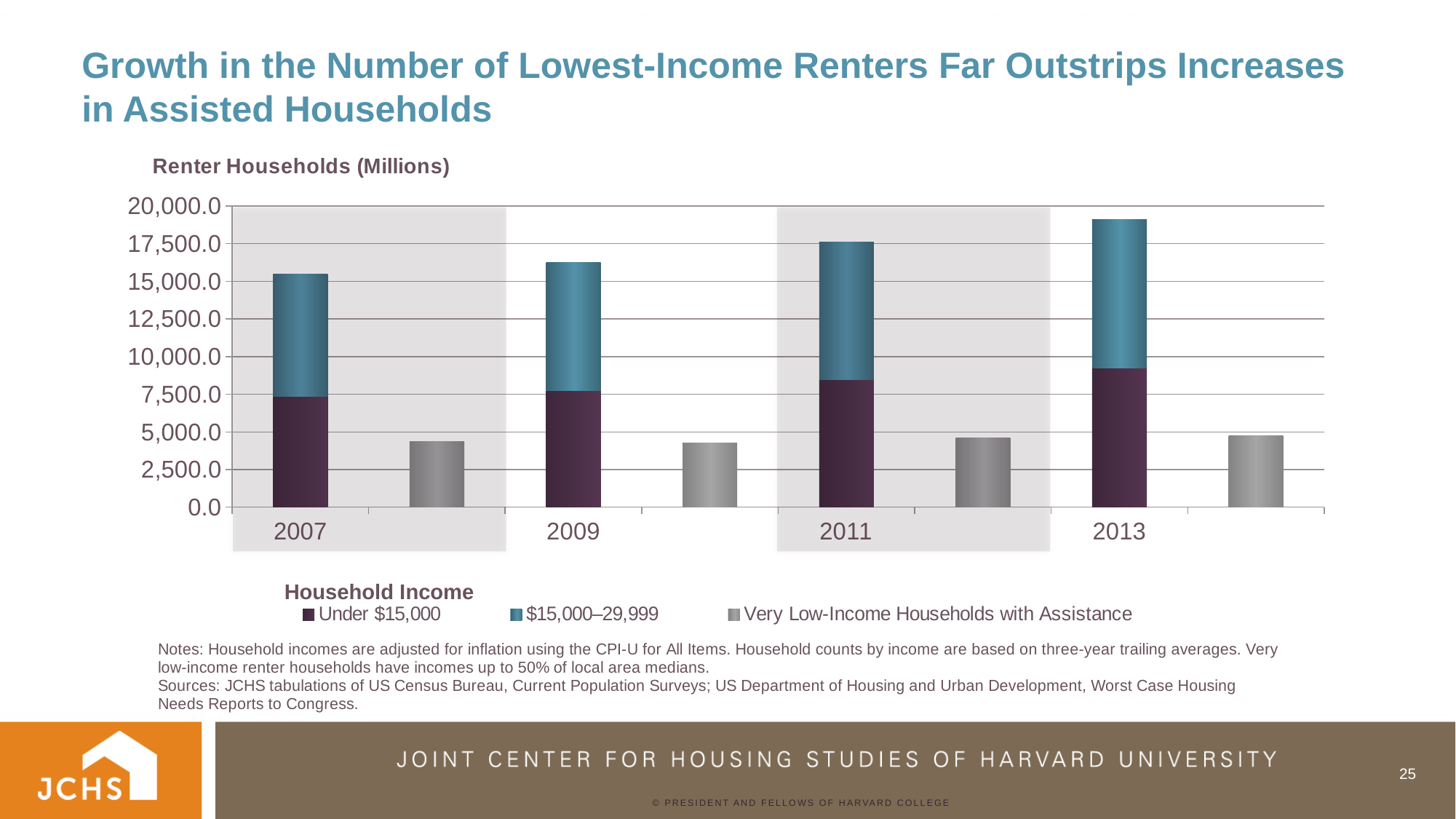
Do the stacked bars for renter households rise or fall from 2007 to 2013? rise How many series does the legend list? 3 How many years are shown on the x axis? 4 Is the total of the stacked bar for 2007 greater or less than 17,500.0? less Is the value for Very Low-Income Households with Assistance in 2013 greater or less than 5,000.0? less Which is larger: the Under $15,000 segment in 2007 or in 2013? 2013 Is the total of the stacked bar for 2013 greater or less than 17,500.0? greater In which year is the stacked bar for renter households (Under $15,000 plus $15,000–29,999) the shortest? 2007 In which year is the stacked bar for renter households (Under $15,000 plus $15,000–29,999) the tallest? 2013 What is the title of the vertical axis? Renter Households (Millions) What kind of chart is shown on the slide? bar chart